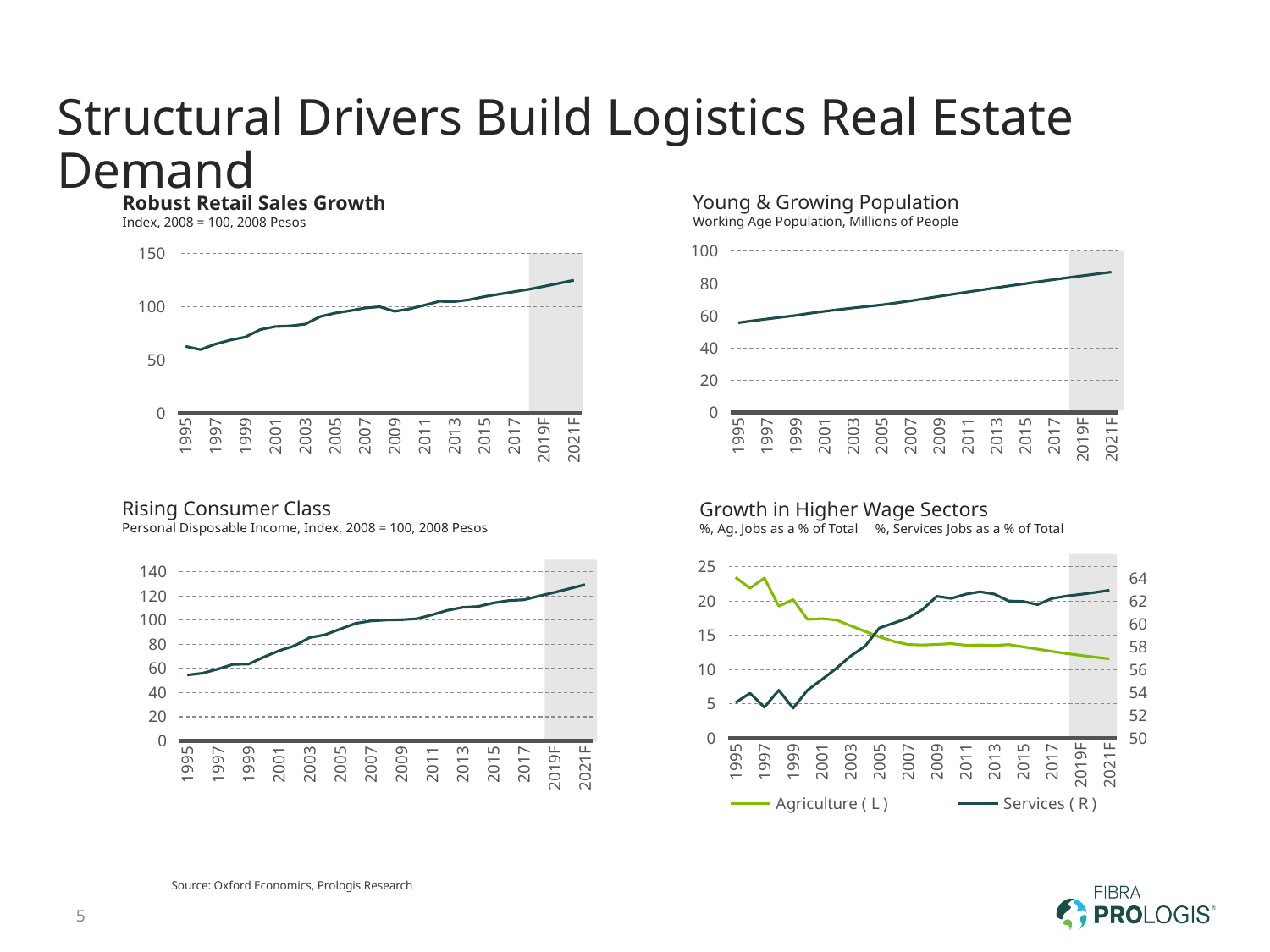
What kind of chart is the 'Robust Retail Sales Growth' chart? line chart How many series does the legend of the 'Growth in Higher Wage Sectors' chart list? 2 In the 'Growth in Higher Wage Sectors' chart, is the Agriculture value for 1995 greater or less than 20? greater In the 'Rising Consumer Class' chart, is the value for 2021F greater or less than 120? greater In the 'Robust Retail Sales Growth' chart, is the value for 1995 greater or less than 100? less In the 'Growth in Higher Wage Sectors' chart, does the Services series rise or fall from 1995 to 2021F? rise In the 'Robust Retail Sales Growth' chart, do values rise or fall from 1995 to 2021F? rise In the 'Young & Growing Population' chart, do values rise or fall along the x axis? rise In the 'Growth in Higher Wage Sectors' chart, which series is drawn in light green? Agriculture ( L )